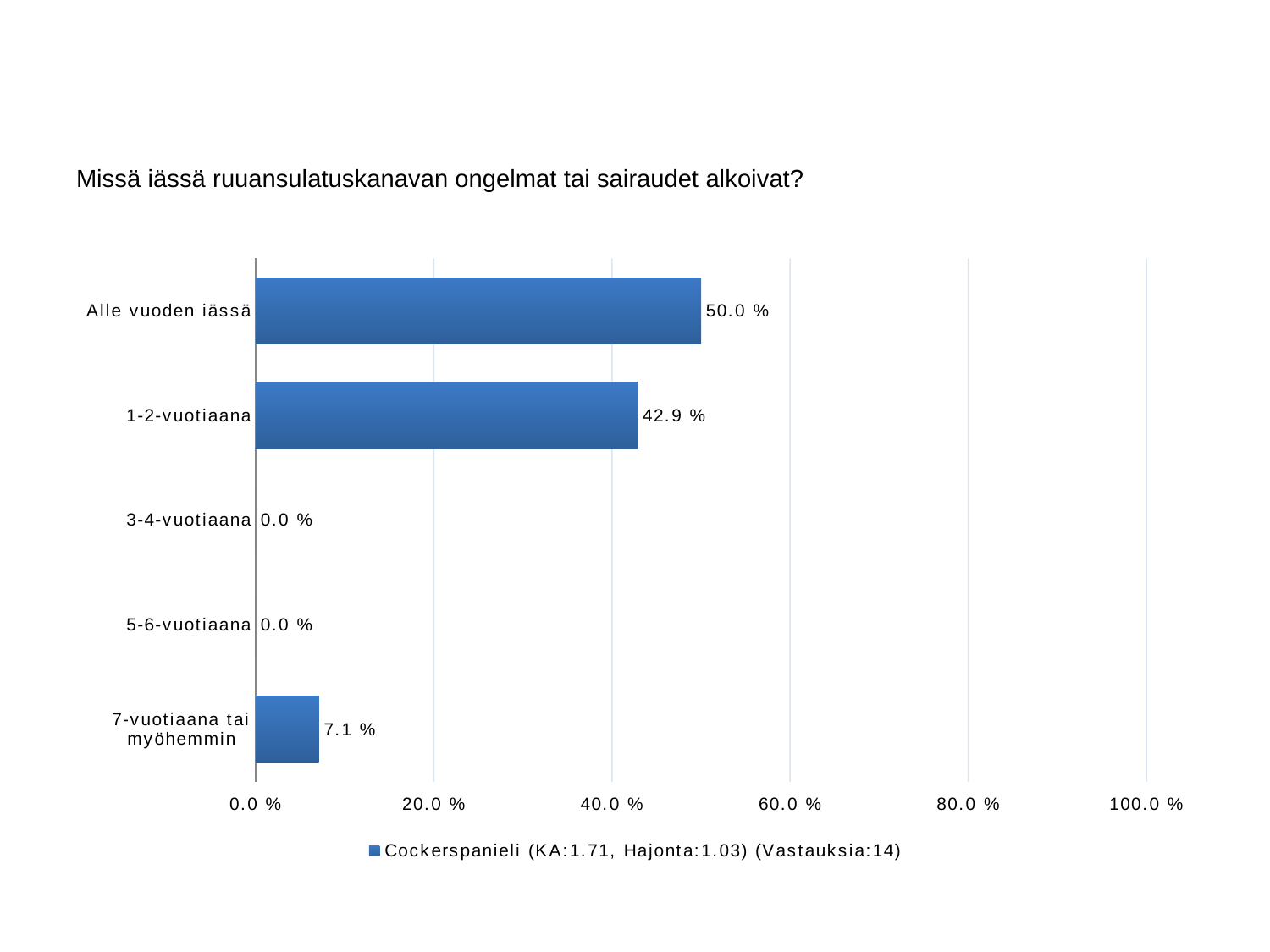
What is the difference between the values for "Alle vuoden iässä" and "1-2-vuotiaana"? 7.1 % How many categories are shown on the chart? 5 What is the value for "7-vuotiaana tai myöhemmin"? 7.1 % How many series does the legend list? 1 Is the value for "1-2-vuotiaana" greater or less than 40.0 %? greater What is the value for "1-2-vuotiaana"? 42.9 % Which category has the highest value? Alle vuoden iässä What is the value for "3-4-vuotiaana"? 0.0 % How many responses (Vastauksia) does the legend entry report? 14 What kind of chart is shown on the slide? Bar chart Which is larger, the value for "1-2-vuotiaana" or the value for "7-vuotiaana tai myöhemmin"? 1-2-vuotiaana What is the value for "Alle vuoden iässä"? 50.0 %